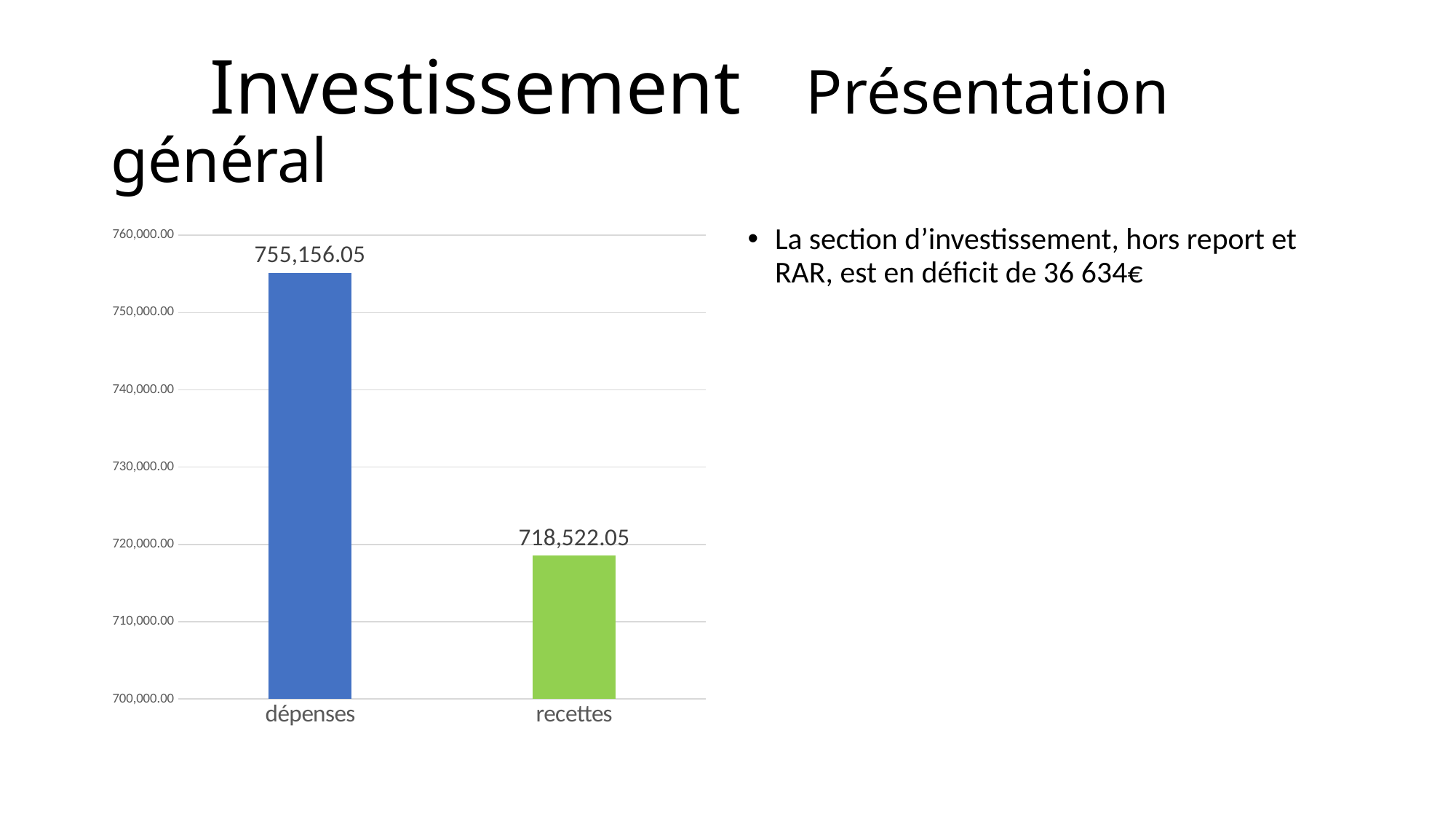
What is the difference between the value for dépenses and the value for recettes? 36,634.00 What is the highest value shown on the vertical axis of the chart? 760,000.00 What is the value for recettes? 718,522.05 Which is larger, the value for dépenses or the value for recettes? dépenses How many categories are shown on the x axis of the chart? 2 Which category has the highest value? dépenses What kind of chart is shown on the slide? bar chart Which category has the lowest value? recettes Is the value for dépenses greater or less than 750,000.00? greater What colour is the bar for recettes? green Is the value for recettes greater or less than 720,000.00? less What is the value for dépenses? 755,156.05